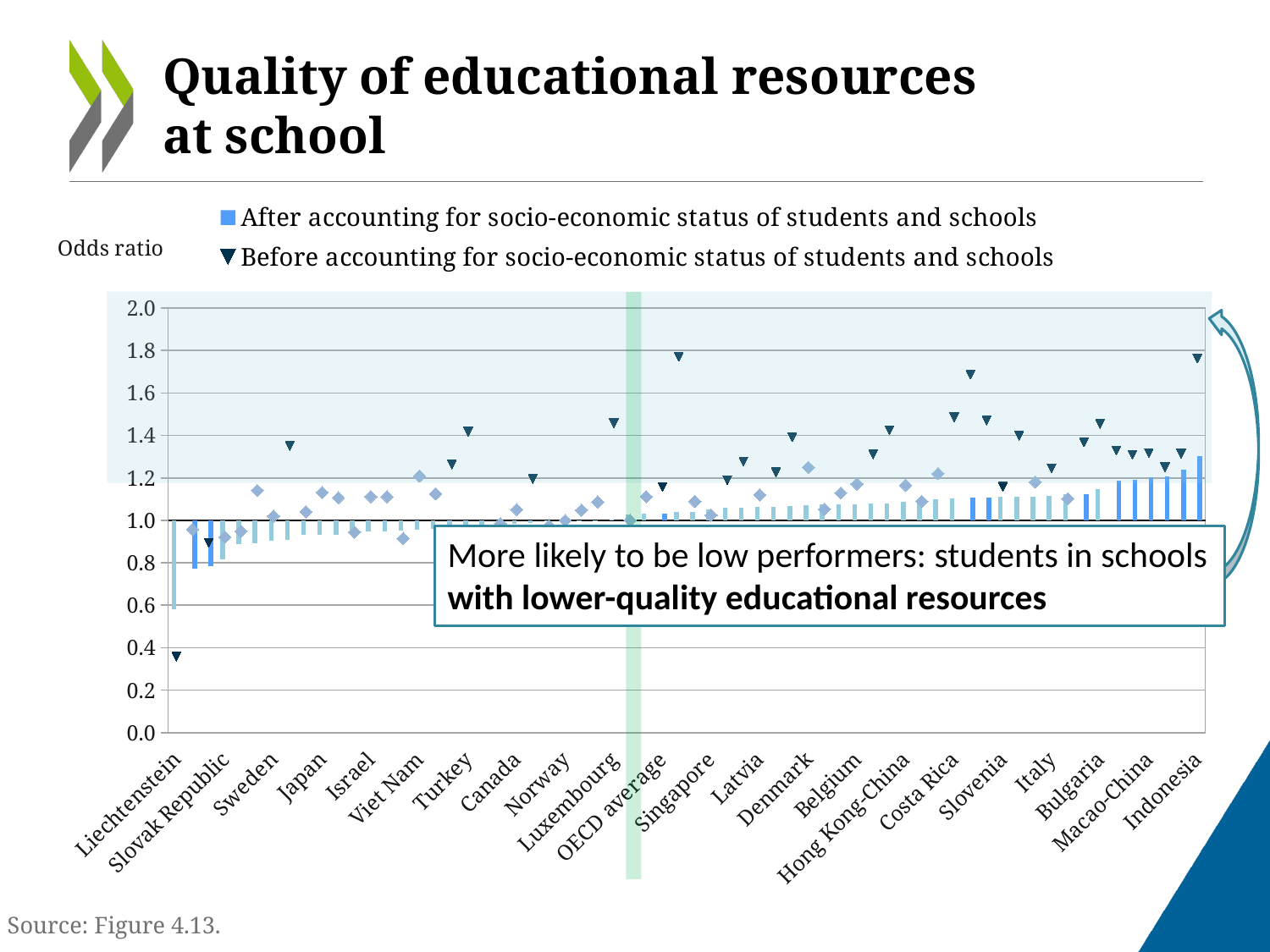
What kind of chart is shown on the slide? combination bar and line chart Which category has the lowest value for 'Before accounting for socio-economic status of students and schools'? Liechtenstein How many series does the legend list? 2 Is the 'After accounting for socio-economic status of students and schools' value for Indonesia greater or less than 1.2? greater Do the 'After accounting for socio-economic status of students and schools' bars generally rise or fall from left to right along the x axis? rise Is the 'After accounting for socio-economic status of students and schools' value for Liechtenstein greater or less than 0.8? less Which category has the lowest value for 'After accounting for socio-economic status of students and schools'? Liechtenstein Which has the larger 'After accounting for socio-economic status of students and schools' value, Liechtenstein or Indonesia? Indonesia Which series is shown with triangle markers in the legend? Before accounting for socio-economic status of students and schools Is the 'Before accounting for socio-economic status of students and schools' value for Liechtenstein greater or less than 0.6? less What is the label on the vertical axis of the chart? Odds ratio